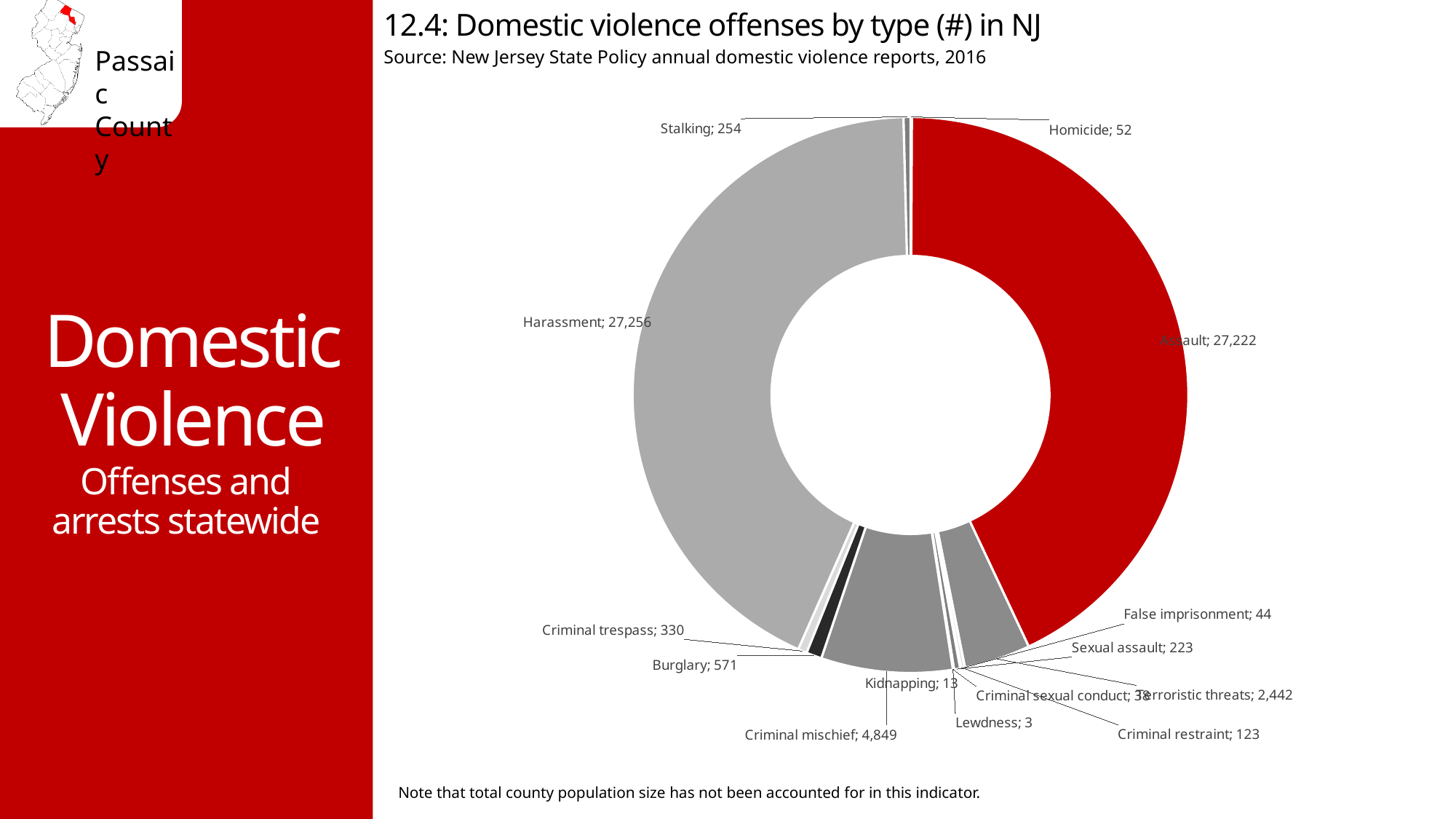
How many Terroristic threats offenses are shown on the chart? 2,442 What kind of chart is shown on the slide? doughnut (pie) chart What is the title of the chart? 12.4: Domestic violence offenses by type (#) in NJ What value is shown for Homicide? 52 How many offense types are shown on the chart? 14 What is the difference between the Criminal mischief and Terroristic threats values? 2,407 Which is larger, the value for Criminal mischief or the value for Terroristic threats? Criminal mischief What value is shown for Criminal mischief? 4,849 What is the number of Harassment offenses shown on the chart? 27,256 What is the number of Assault offenses shown on the chart? 27,222 Which offense type has the lowest value on the chart? Lewdness What is the difference between the Burglary and Criminal trespass values? 241